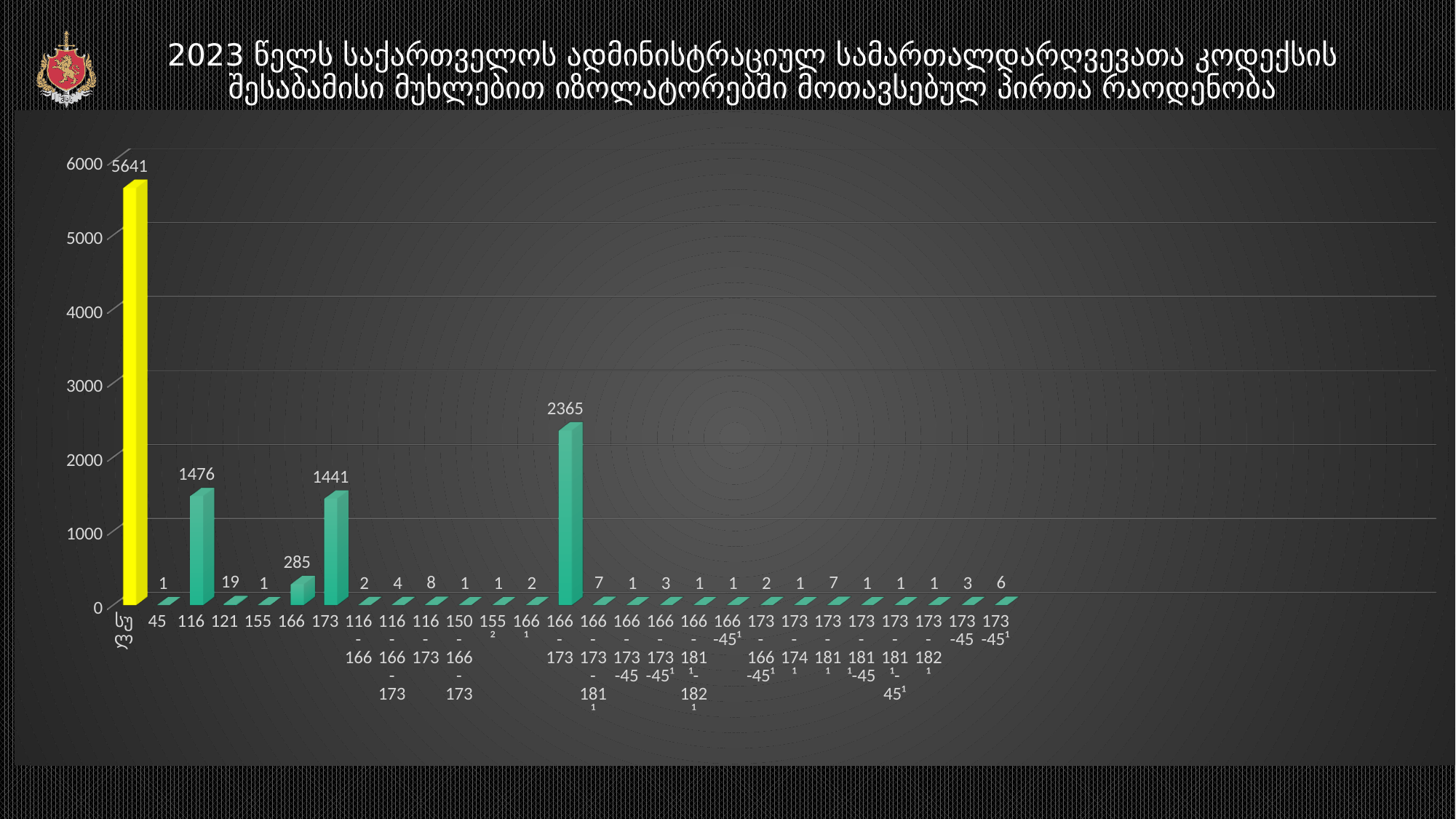
What kind of chart is shown on the slide? bar chart What is the value for the category სულ? 5641 What is the value for the category 166-173? 2365 What is the difference between the values for 116 and 173? 35 What is the value for article 166? 285 What is the value for article 121? 19 What is the value for article 116? 1476 Excluding the სულ total bar, which category has the highest value? 166-173 Which is larger, the value for 166-173 or the value for 116? 166-173 How many categories are shown on the x axis? 27 What is the value for article 173? 1441 Is the value for სულ greater or less than 5000? greater